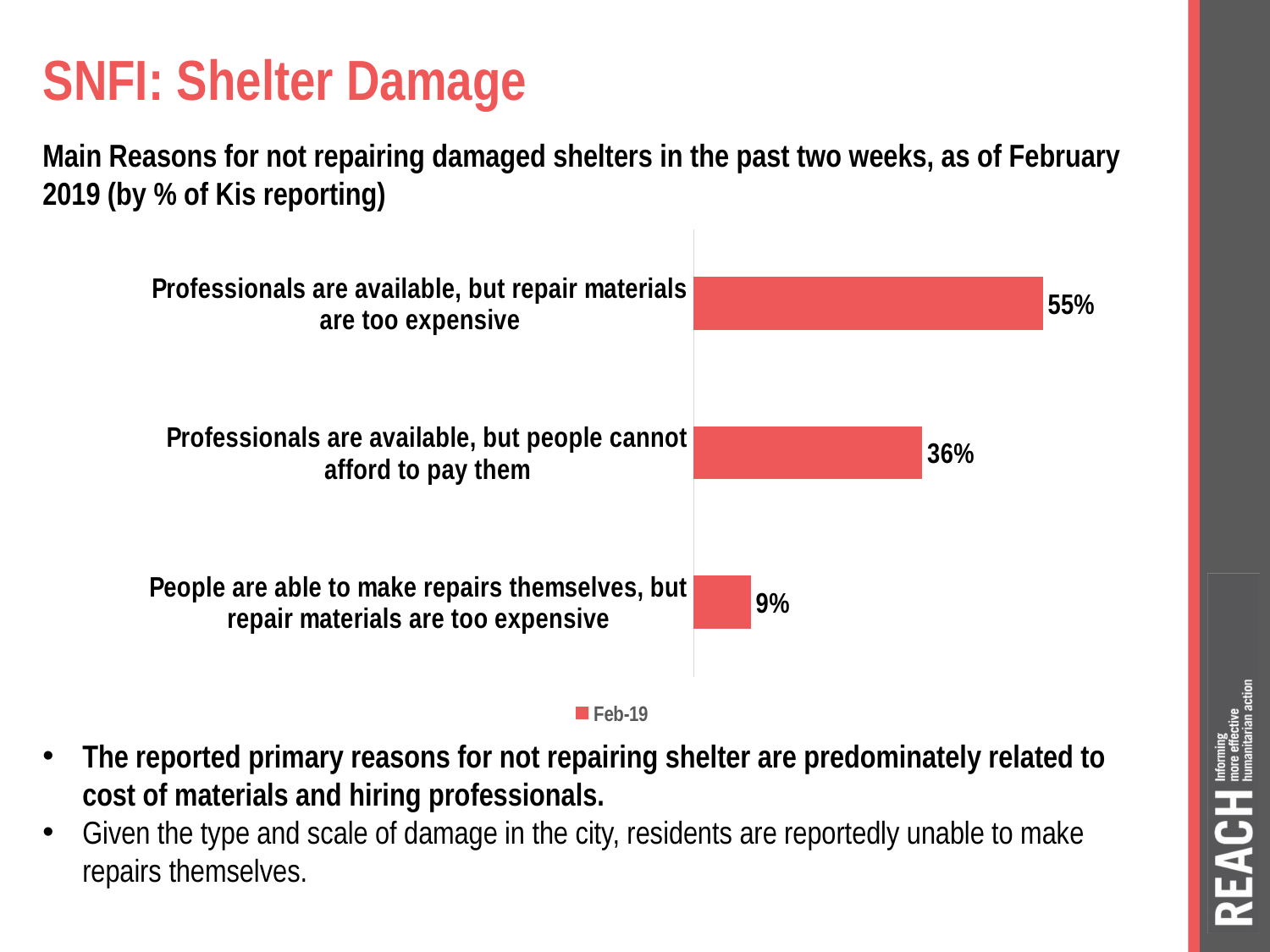
What percentage of KIs reported that professionals are available, but repair materials are too expensive? 55% What is the legend entry shown below the chart? Feb-19 How many reasons (categories) are shown in the chart? 3 What percentage of KIs reported that people are able to make repairs themselves, but repair materials are too expensive? 9% Which is larger: the percentage for 'Professionals are available, but people cannot afford to pay them' or for 'People are able to make repairs themselves, but repair materials are too expensive'? Professionals are available, but people cannot afford to pay them Which reason for not repairing damaged shelters has the highest percentage? Professionals are available, but repair materials are too expensive What percentage of KIs reported that professionals are available, but people cannot afford to pay them? 36% What is the difference in percentage points between 'Professionals are available, but repair materials are too expensive' and 'Professionals are available, but people cannot afford to pay them'? 19 percentage points What is the difference in percentage points between 'Professionals are available, but people cannot afford to pay them' and 'People are able to make repairs themselves, but repair materials are too expensive'? 27 percentage points Which reason for not repairing damaged shelters has the lowest percentage? People are able to make repairs themselves, but repair materials are too expensive How many series does the legend list? 1 What kind of chart is shown on the slide? Bar chart